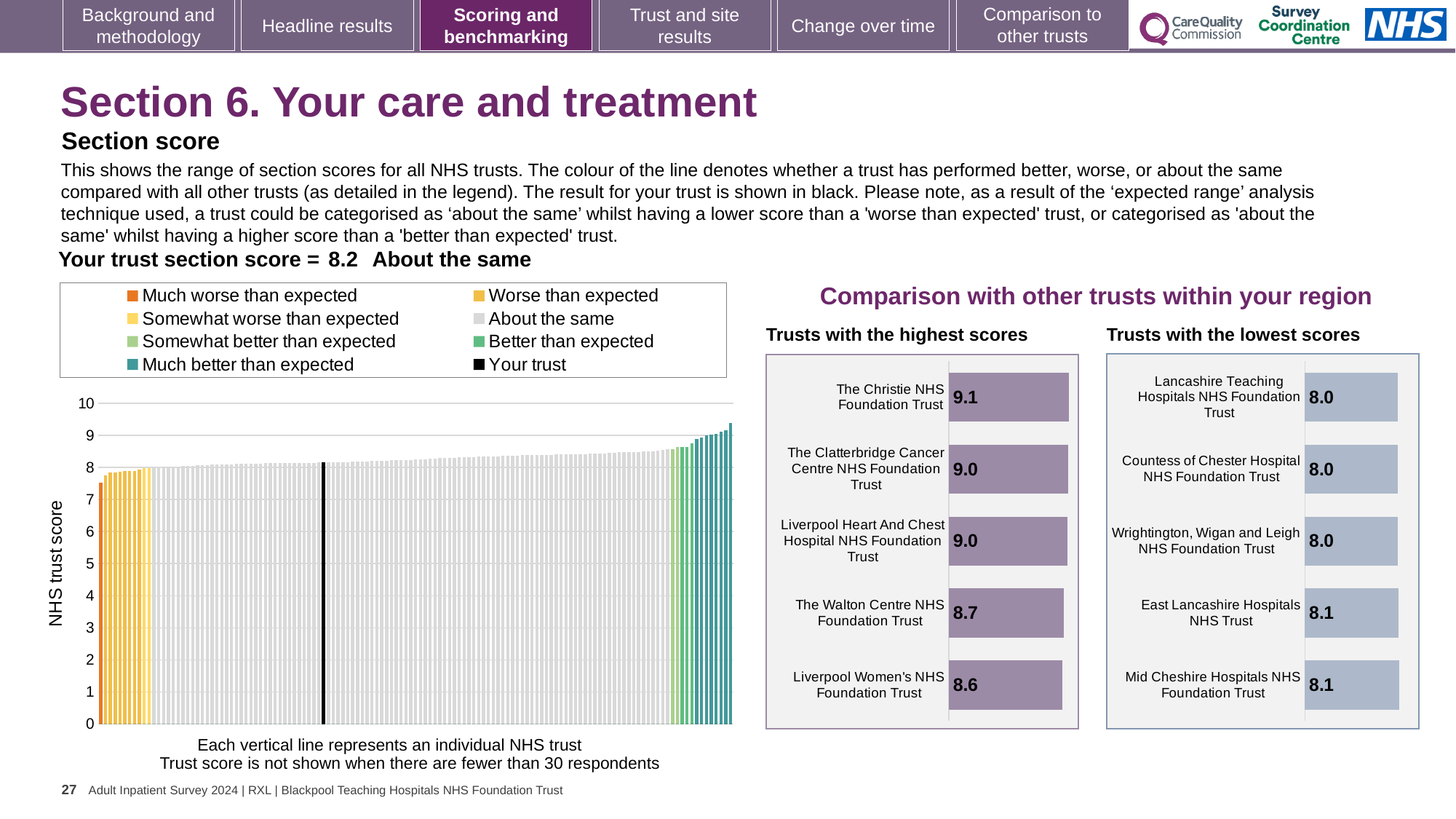
What kind of chart is the large 'NHS trust score' chart on the left? Bar chart In the 'Trusts with the highest scores' chart, which trust has the highest score? The Christie NHS Foundation Trust How many trusts are shown in the 'Trusts with the lowest scores' chart? 5 In the 'Trusts with the lowest scores' chart, what is the score for East Lancashire Hospitals NHS Trust? 8.1 Which has the larger score: The Walton Centre NHS Foundation Trust in the highest scores chart or Mid Cheshire Hospitals NHS Foundation Trust in the lowest scores chart? The Walton Centre NHS Foundation Trust In the 'Trusts with the highest scores' chart, what is the score for The Christie NHS Foundation Trust? 9.1 In the 'Trusts with the lowest scores' chart, what is the score for Countess of Chester Hospital NHS Foundation Trust? 8.0 In the 'Trusts with the highest scores' chart, what is the score for The Walton Centre NHS Foundation Trust? 8.7 In the 'Trusts with the highest scores' chart, what is the difference between the scores of The Christie NHS Foundation Trust and Liverpool Women's NHS Foundation Trust? 0.5 How many entries does the legend of the large 'NHS trust score' chart on the left list? 8 In the large 'NHS trust score' chart on the left, what is the section score for your trust? 8.2 In the 'Trusts with the highest scores' chart, which trust has the lowest score? Liverpool Women's NHS Foundation Trust